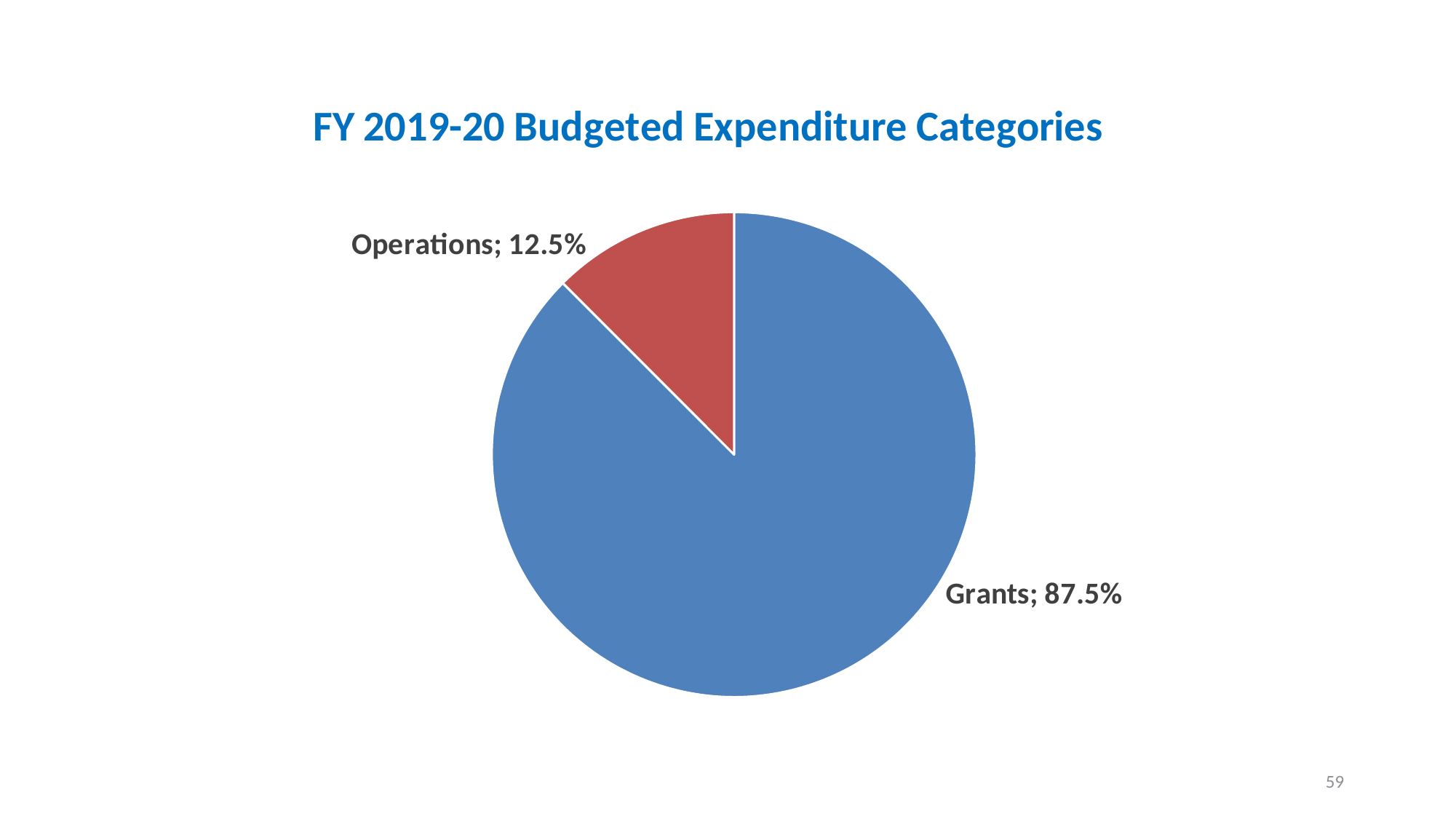
How many categories are shown in the pie chart? 2 What share of the pie does Operations represent? 12.5% What share of the pie does Grants represent? 87.5% What is the difference in percentage points between the Grants and Operations slices? 75 percentage points What is the combined share of the Grants and Operations slices? 100% Which category has the largest slice of the pie? Grants What kind of chart is shown on the slide? Pie chart What is the title of the chart? FY 2019-20 Budgeted Expenditure Categories What colour is the Operations slice? Red Which category has the smallest slice of the pie? Operations Which is larger, the Grants slice or the Operations slice? Grants